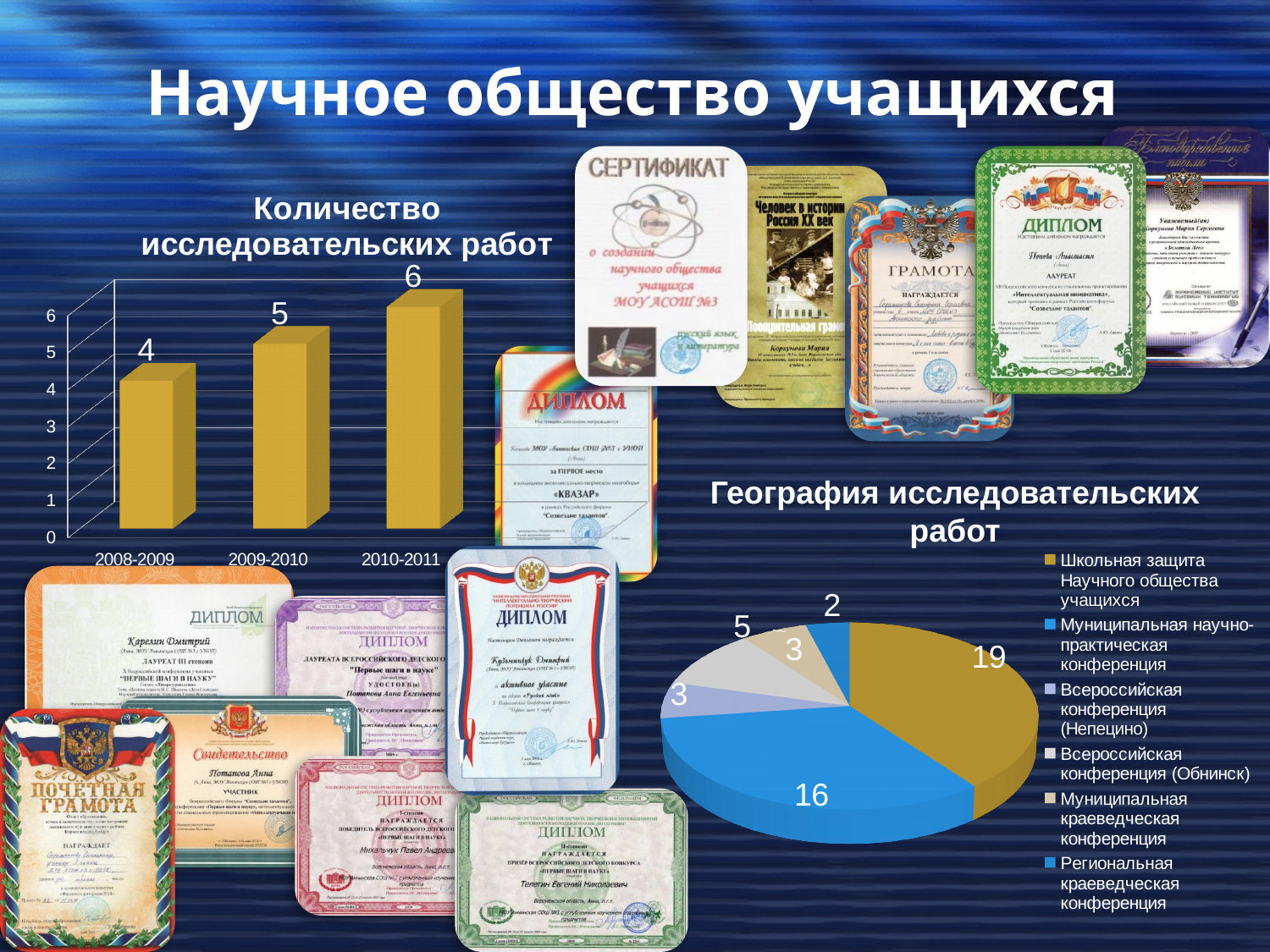
On the bar chart 'Количество исследовательских работ', what is the value for 2008-2009? 4 On the bar chart 'Количество исследовательских работ', which period has the highest value? 2010-2011 How many categories does the legend of the pie chart 'География исследовательских работ' list? 6 On the bar chart 'Количество исследовательских работ', what is the value for 2010-2011? 6 On the pie chart 'География исследовательских работ', which category has the largest slice? Школьная защита Научного общества учащихся What kind of chart is 'Количество исследовательских работ'? bar chart What kind of chart is 'География исследовательских работ'? pie chart On the bar chart 'Количество исследовательских работ', what is the difference between the values for 2010-2011 and 2008-2009? 2 On the pie chart 'География исследовательских работ', what is the value for 'Школьная защита Научного общества учащихся'? 19 How many periods are shown on the bar chart 'Количество исследовательских работ'? 3 On the bar chart 'Количество исследовательских работ', do the values rise or fall from 2008-2009 to 2010-2011? rise On the bar chart 'Количество исследовательских работ', which period has the lowest value? 2008-2009